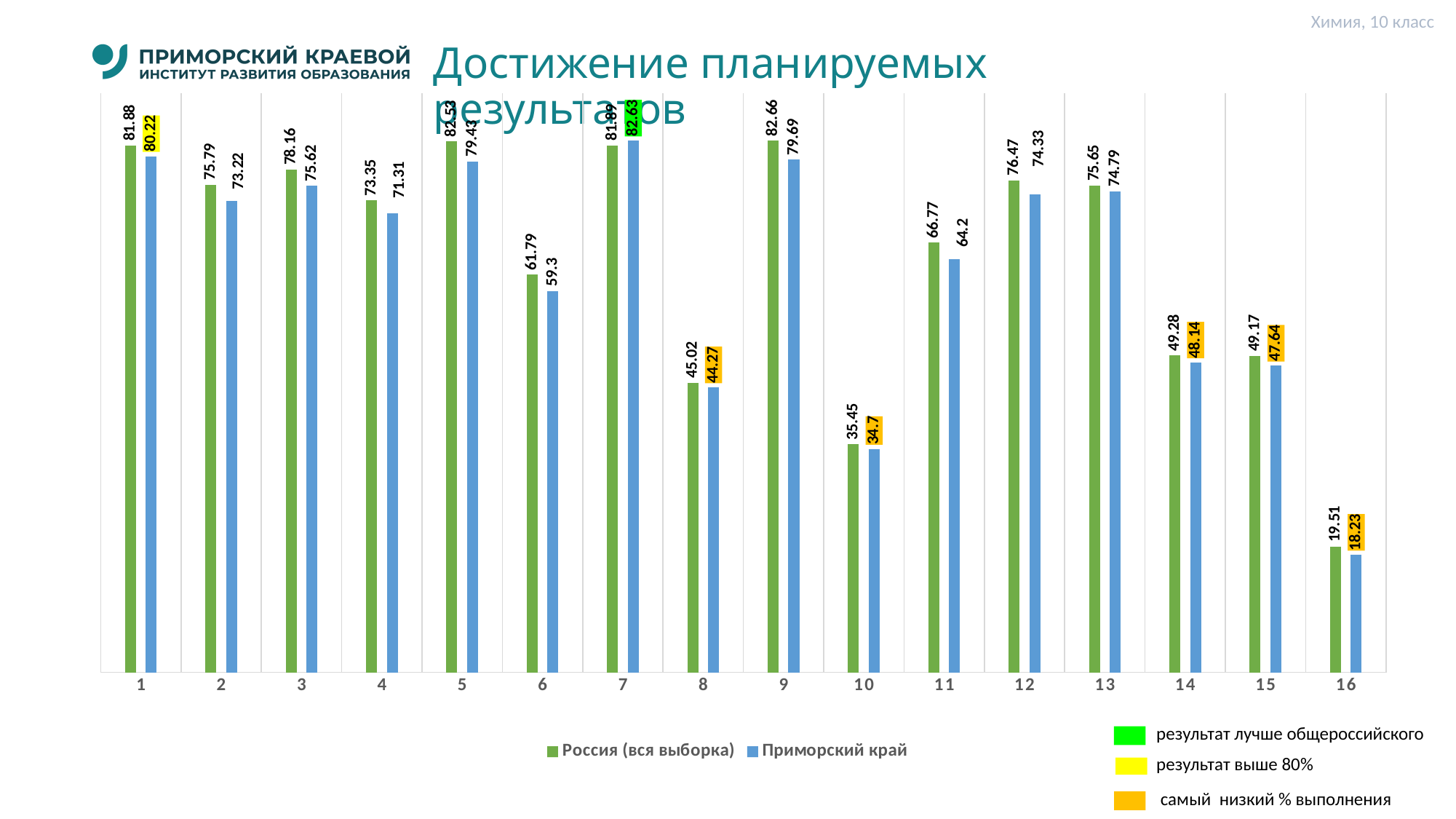
What kind of chart is shown on the slide? bar chart What is the value for Россия (вся выборка) for category 11? 66.77 Which is larger for category 7: Россия (вся выборка) or Приморский край? Приморский край What is the value for Россия (вся выборка) for category 9? 82.66 What is the difference between Россия (вся выборка) and Приморский край for category 6? 2.49 What is the value for Приморский край for category 1? 80.22 Which category has the lowest value for Приморский край? 16 Which category has the highest value for Приморский край? 7 What is the value for Приморский край for category 16? 18.23 How many series does the chart legend list? 2 Which colour represents Приморский край in the chart? blue How many categories are shown on the x axis? 16